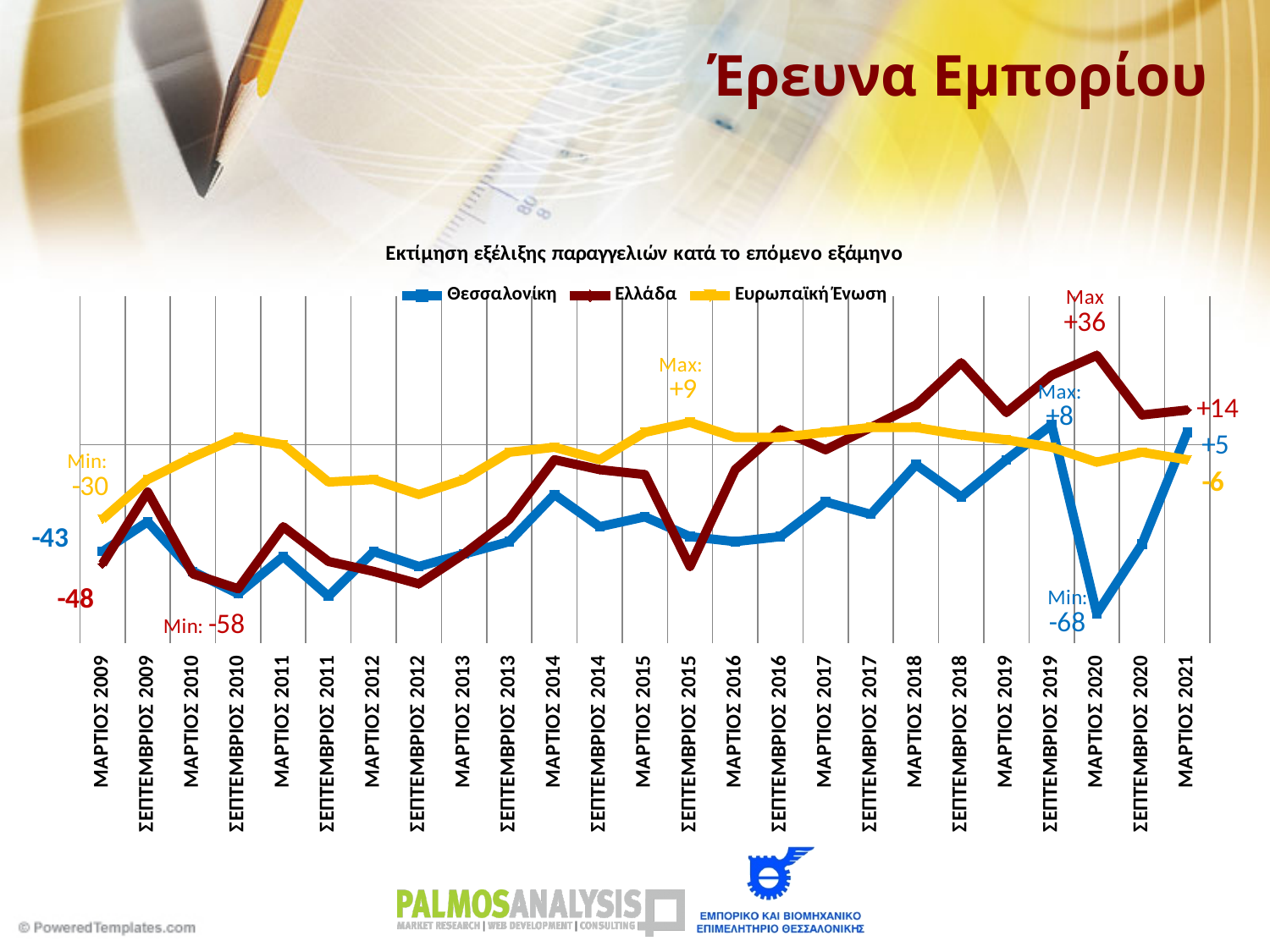
How many series does the legend list? 3 What is the difference between the Ελλάδα and Θεσσαλονίκη values in ΜΑΡΤΙΟΣ 2021? 9 What is the maximum value reached by the Ελλάδα series, and in which period? +36, ΜΑΡΤΙΟΣ 2020 How many time periods are shown on the x axis? 25 What is the value for Ευρωπαϊκή Ένωση in ΜΑΡΤΙΟΣ 2021? -6 What is the value for Θεσσαλονίκη in ΜΑΡΤΙΟΣ 2021? +5 What is the value for Θεσσαλονίκη in ΜΑΡΤΙΟΣ 2009? -43 What is the minimum value reached by the Θεσσαλονίκη series, and in which period? -68, ΜΑΡΤΙΟΣ 2020 In ΜΑΡΤΙΟΣ 2021, which series has the larger value: Ελλάδα or Ευρωπαϊκή Ένωση? Ελλάδα What type of chart is shown on the slide? Line chart What is the minimum value of the Ευρωπαϊκή Ένωση series? -30 What is the value for Ελλάδα in ΜΑΡΤΙΟΣ 2021? +14